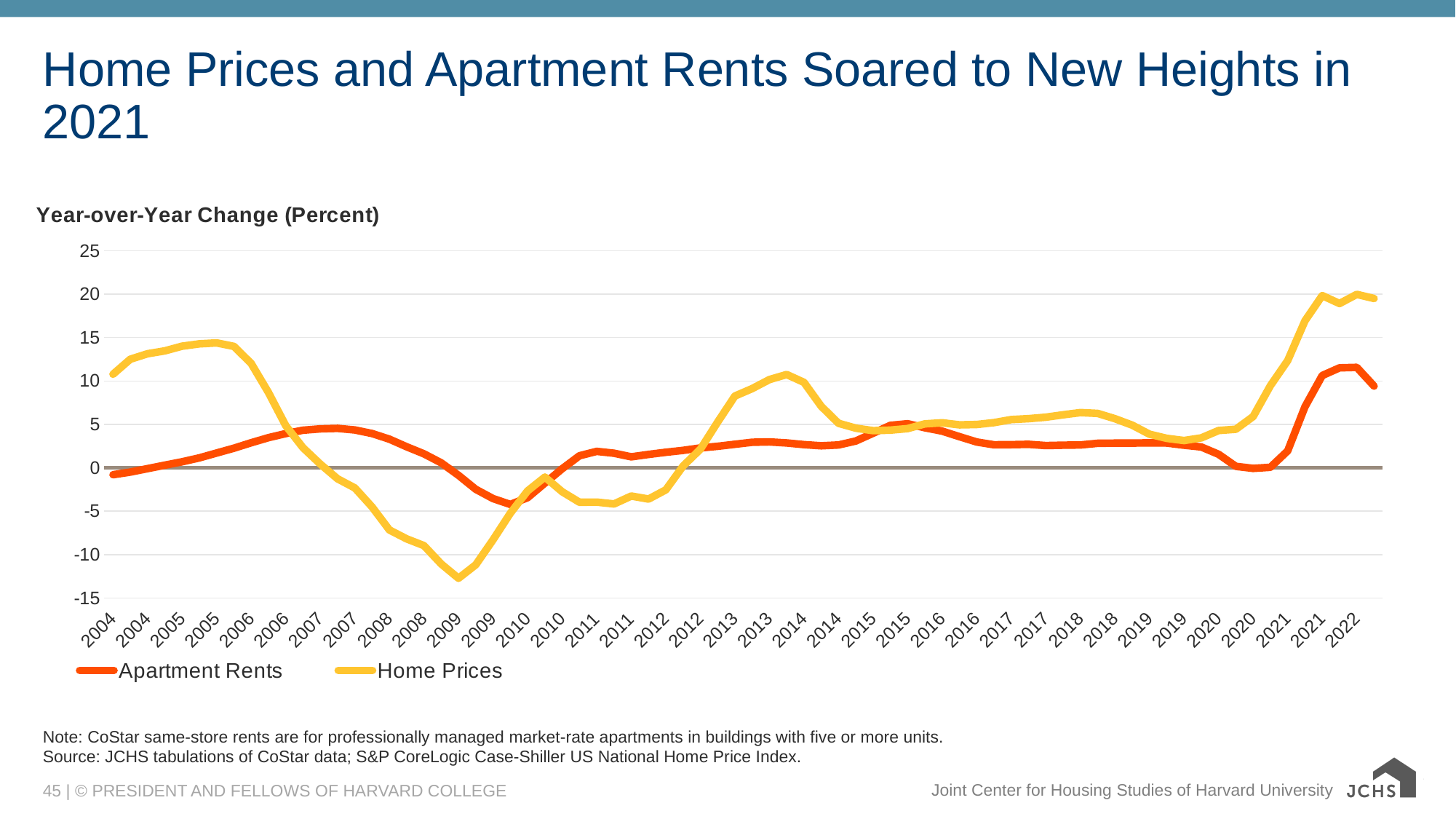
Is the peak value of the Apartment Rents line, around 2021, greater or less than 10? greater Which series reaches the highest value anywhere on the chart? Home Prices Does the Home Prices line rise or fall between 2005 and 2009? Fall Is the lowest value of the Home Prices line, around 2009, greater or less than -10? less What does the vertical axis of the chart measure, according to its label? Year-over-Year Change (Percent) What kind of chart is shown on the slide? Line chart Is the peak value of the Home Prices line, around 2021-2022, greater or less than 15? greater At the end of the chart in 2022, which series has the higher value, Apartment Rents or Home Prices? Home Prices What is the title of the chart on the slide? Year-over-Year Change (Percent) Which series reaches the lowest value anywhere on the chart? Home Prices How many series does the legend list? 2 Around 2009, which series has the higher value, Apartment Rents or Home Prices? Apartment Rents